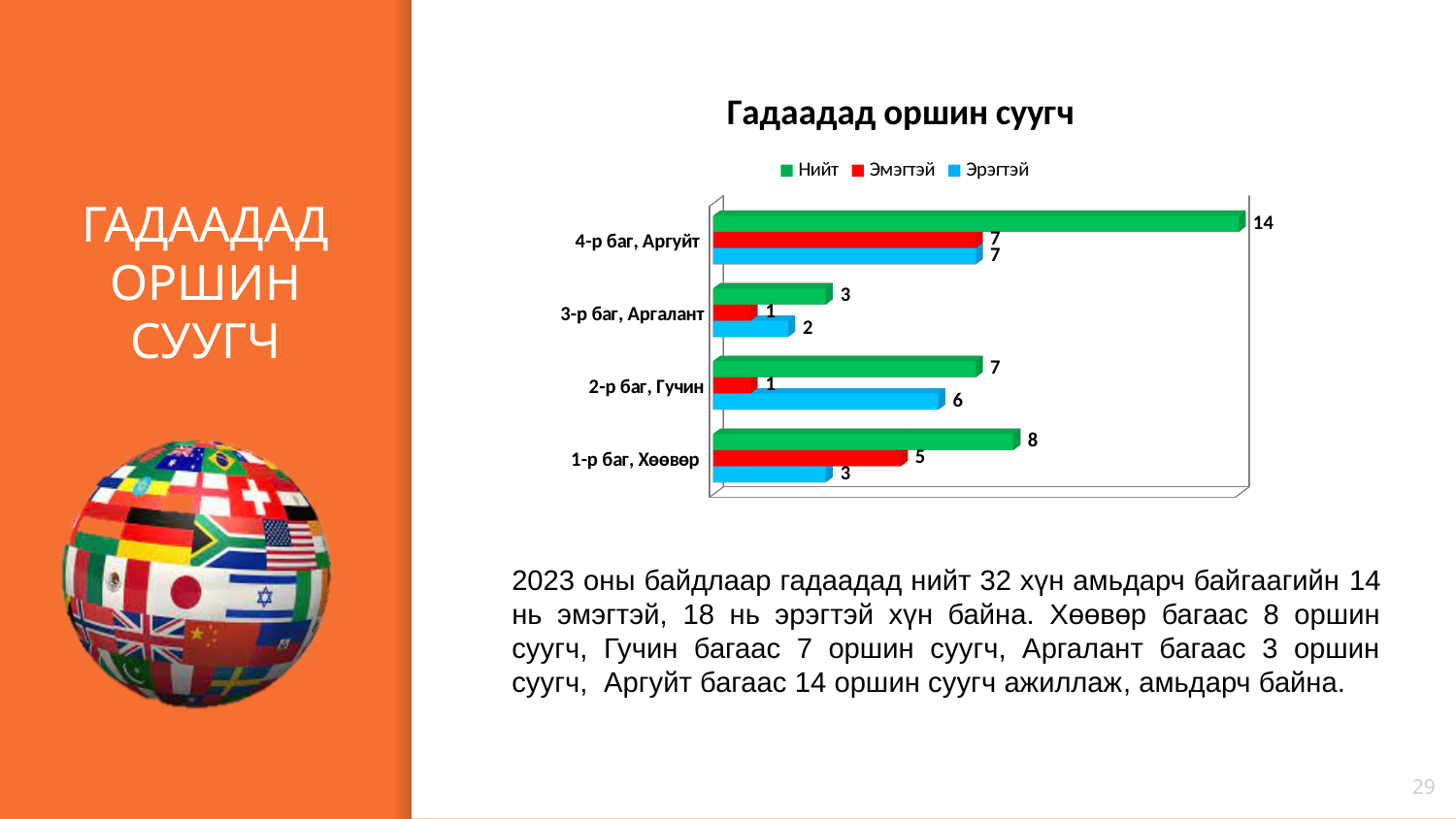
How many categories are shown on the chart? 4 Which is larger, the Эрэгтэй value for 2-р баг, Гучин or the Эрэгтэй value for 1-р баг, Хөөвөр? 2-р баг, Гучин What kind of chart is shown on the slide? Bar chart What is the value of Нийт for 4-р баг, Аргуйт? 14 What is the value of Эрэгтэй for 2-р баг, Гучин? 6 Which category has the highest Нийт value? 4-р баг, Аргуйт Which category has the lowest Нийт value? 3-р баг, Аргалант Which series is shown in red? Эмэгтэй What is the title of the chart? Гадаадад оршин суугч What is the difference between the Нийт values for 4-р баг, Аргуйт and 1-р баг, Хөөвөр? 6 How many series does the legend list? 3 What is the value of Эмэгтэй for 1-р баг, Хөөвөр? 5